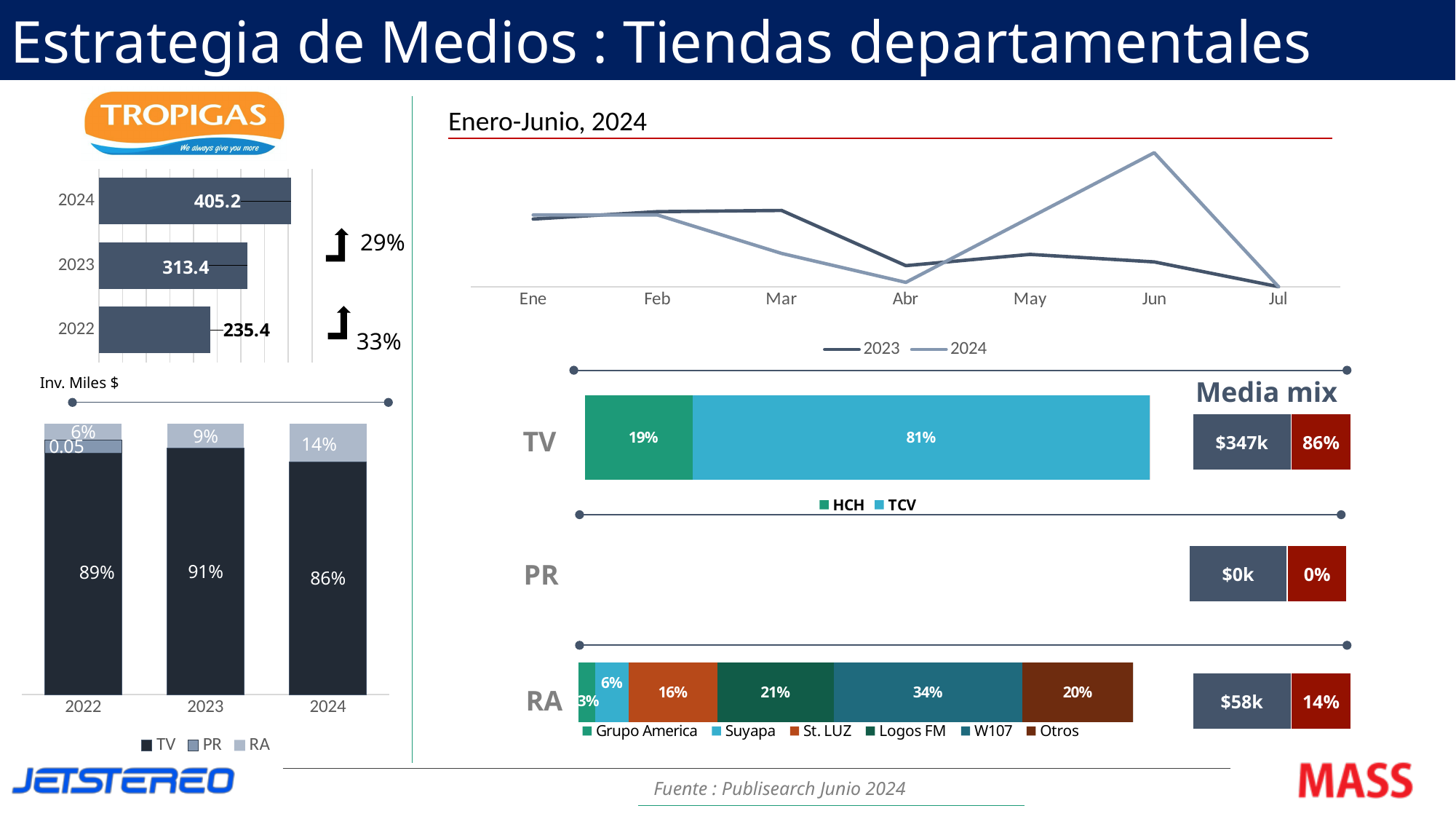
In the bottom-left stacked bar chart, what is the TV share for 2023? 91% In the TV stacked bar on the right, what is the share for TCV? 81% In the line chart titled 'Enero-Junio, 2024', in which month does the 2024 line reach its highest point? Jun In the top-left horizontal bar chart (Inv. Miles $), which year has the highest value? 2024 How many series does the legend of the bottom-left stacked bar chart list? 3 How many months are shown on the x axis of the line chart titled 'Enero-Junio, 2024'? 7 In the Media mix boxes on the right, what is the dollar amount shown for RA? $58k In the top-left horizontal bar chart (Inv. Miles $), what is the value for 2022? 235.4 In the RA stacked bar on the right, which station has the largest share? W107 In the bottom-left stacked bar chart, what is the RA share for 2024? 14% In the top-left horizontal bar chart (Inv. Miles $), what is the value for 2024? 405.2 In the top-left horizontal bar chart (Inv. Miles $), what is the difference between the 2024 and 2023 values? 91.8